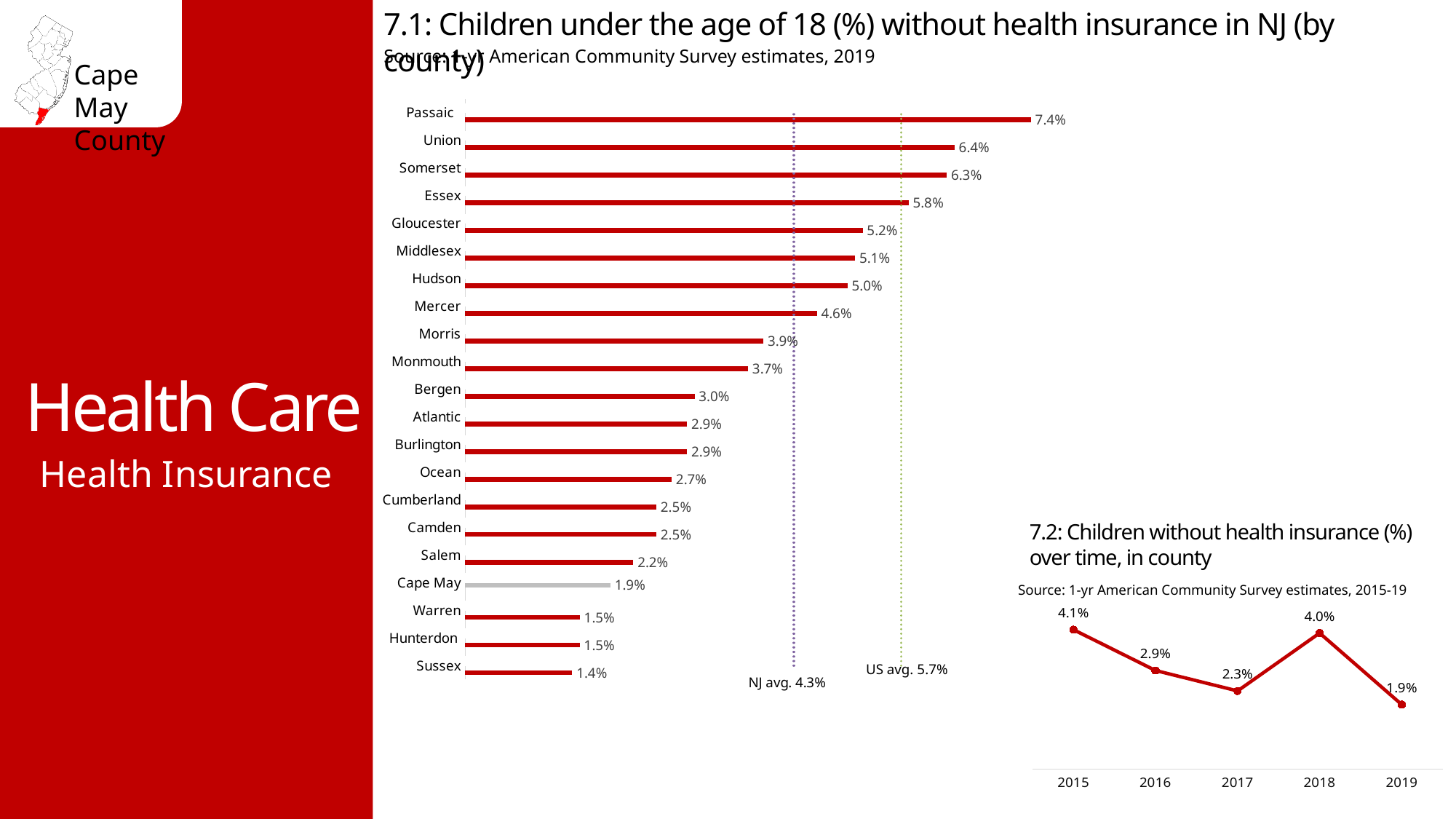
In chart 7.1, how many counties are shown? 21 In chart 7.1, what is the value for Cape May? 1.9% What kind of chart is chart 7.2? line chart In chart 7.1, which county has the lowest percentage of children without health insurance? Sussex In chart 7.1, what NJ average is marked by the dotted line? 4.3% In chart 7.1, what is the value for Hudson? 5.0% In chart 7.1, which is larger, the value for Mercer or the value for Morris? Mercer In chart 7.2, what is the difference between the values for 2015 and 2019? 2.2% In chart 7.2, how many years are plotted? 5 In chart 7.1, which county has the highest percentage of children without health insurance? Passaic In chart 7.1, what is the difference between the values for Passaic and Sussex? 6.0% In chart 7.2, what is the value for 2018? 4.0%